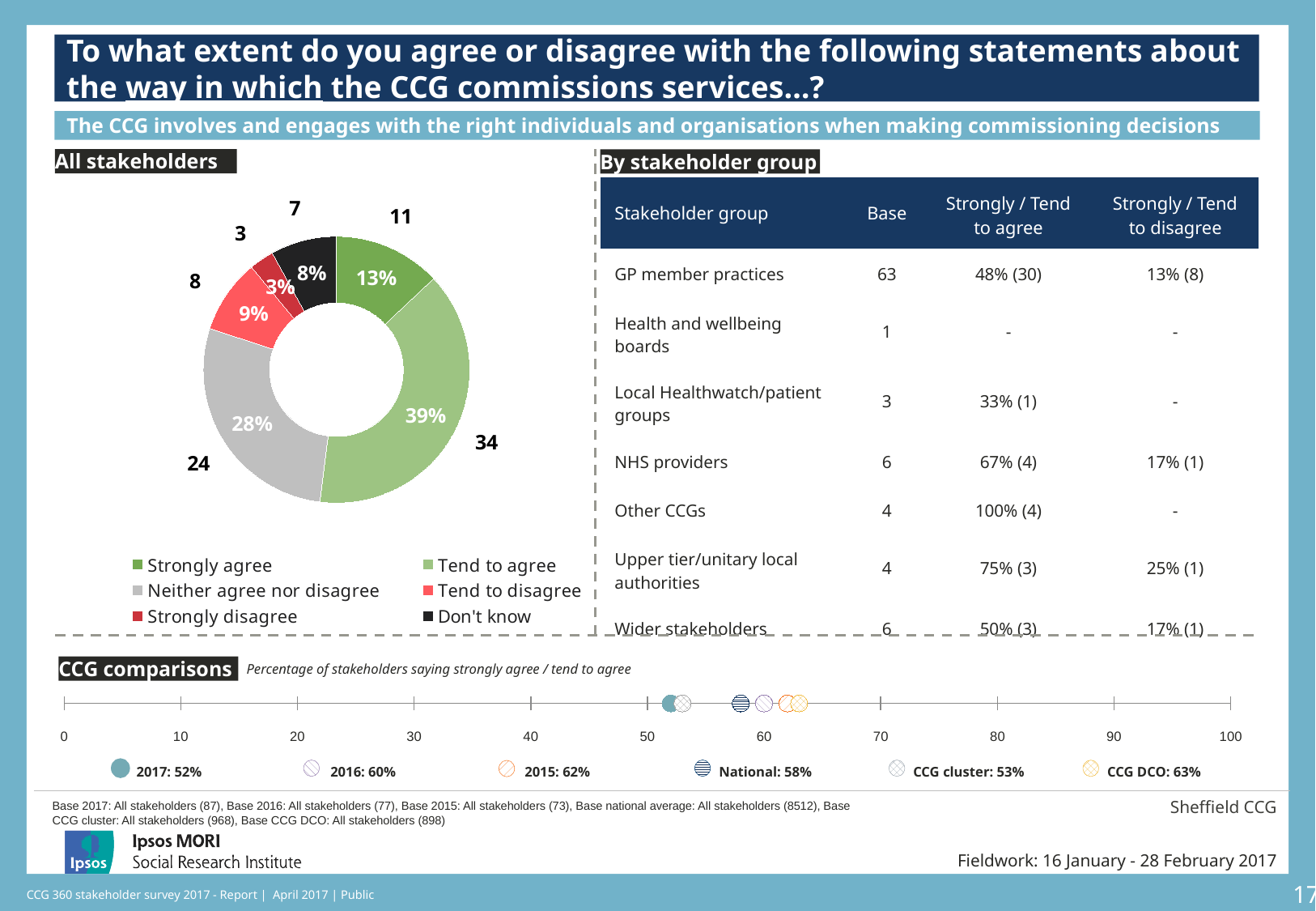
In the 'CCG comparisons' chart, what percentage of stakeholders said strongly agree / tend to agree in 2017? 52% What kind of chart is the 'All stakeholders' chart? Donut chart In the 'All stakeholders' donut chart, what colour is the 'Neither agree nor disagree' segment? Grey In the 'All stakeholders' donut chart, which response category has the largest share? Tend to agree In the 'All stakeholders' donut chart, what is the difference in percentage points between 'Tend to agree' and 'Strongly agree'? 26 In the 'All stakeholders' donut chart, which is larger: the share for 'Tend to disagree' or the share for 'Don't know'? Tend to disagree In the 'All stakeholders' donut chart, which response category has the smallest share? Strongly disagree In the 'All stakeholders' donut chart, how many stakeholders said 'Neither agree nor disagree'? 24 In the 'All stakeholders' donut chart, what percentage of stakeholders said 'Tend to agree'? 39% In the 'CCG comparisons' chart, which comparator has the highest percentage? CCG DCO: 63% In the 'CCG comparisons' chart, did the percentage saying strongly agree / tend to agree rise or fall from 2015 to 2017? Fall How many response categories does the legend of the 'All stakeholders' chart list? 6